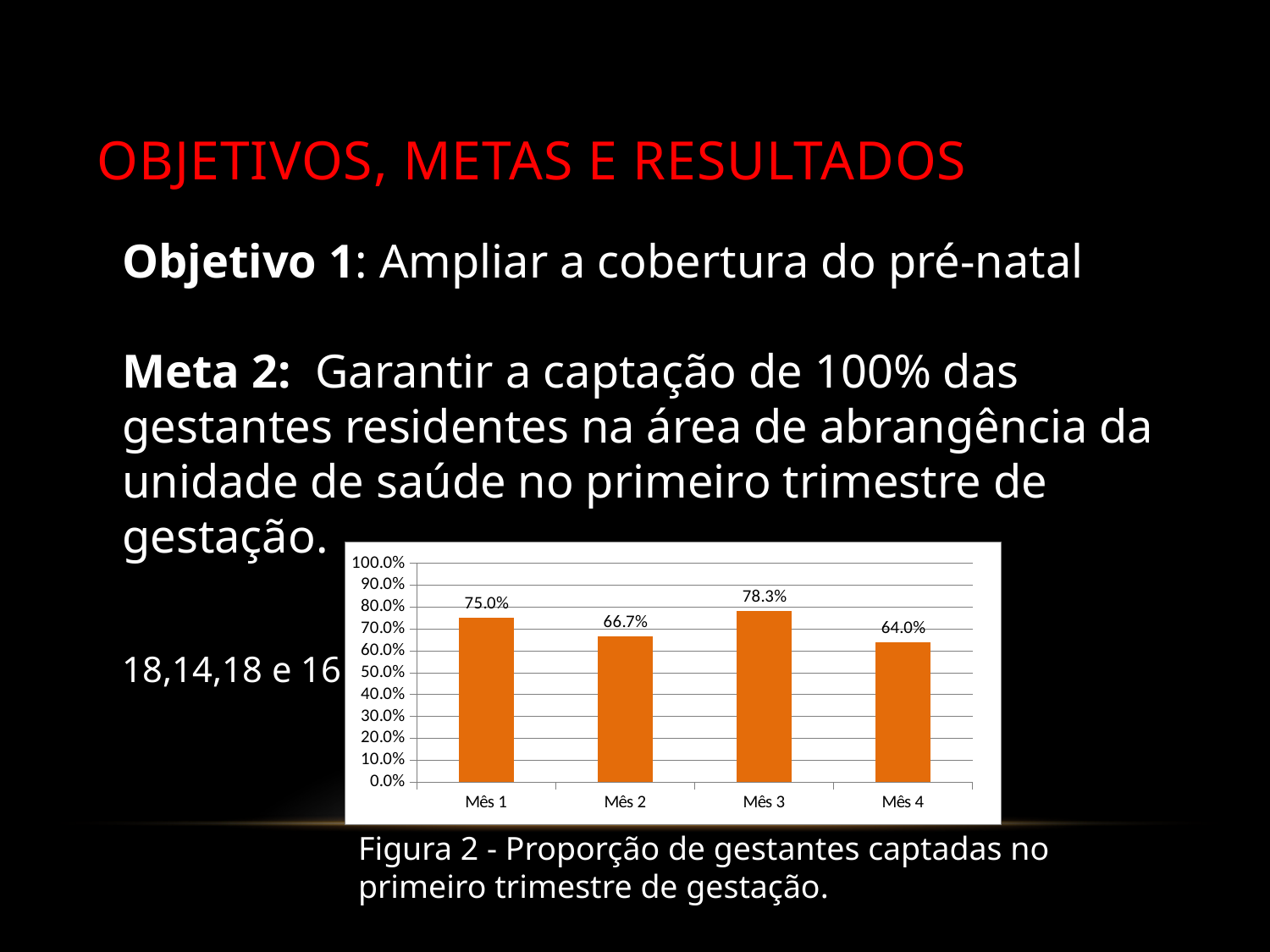
Which is larger, the value for Mês 1 or the value for Mês 2? Mês 1 What is the value for Mês 1? 75.0% Which month has the lowest value? Mês 4 What kind of chart is shown on the slide? bar chart Which month has the highest value? Mês 3 Is the value for Mês 2 greater or less than 70.0%? less What is the caption of the figure below the chart? Figura 2 - Proporção de gestantes captadas no primeiro trimestre de gestação. How many months are shown on the x axis? 4 What is the value for Mês 2? 66.7% What is the difference between the values for Mês 3 and Mês 4? 14.3% What is the value for Mês 4? 64.0% What is the value for Mês 3? 78.3%